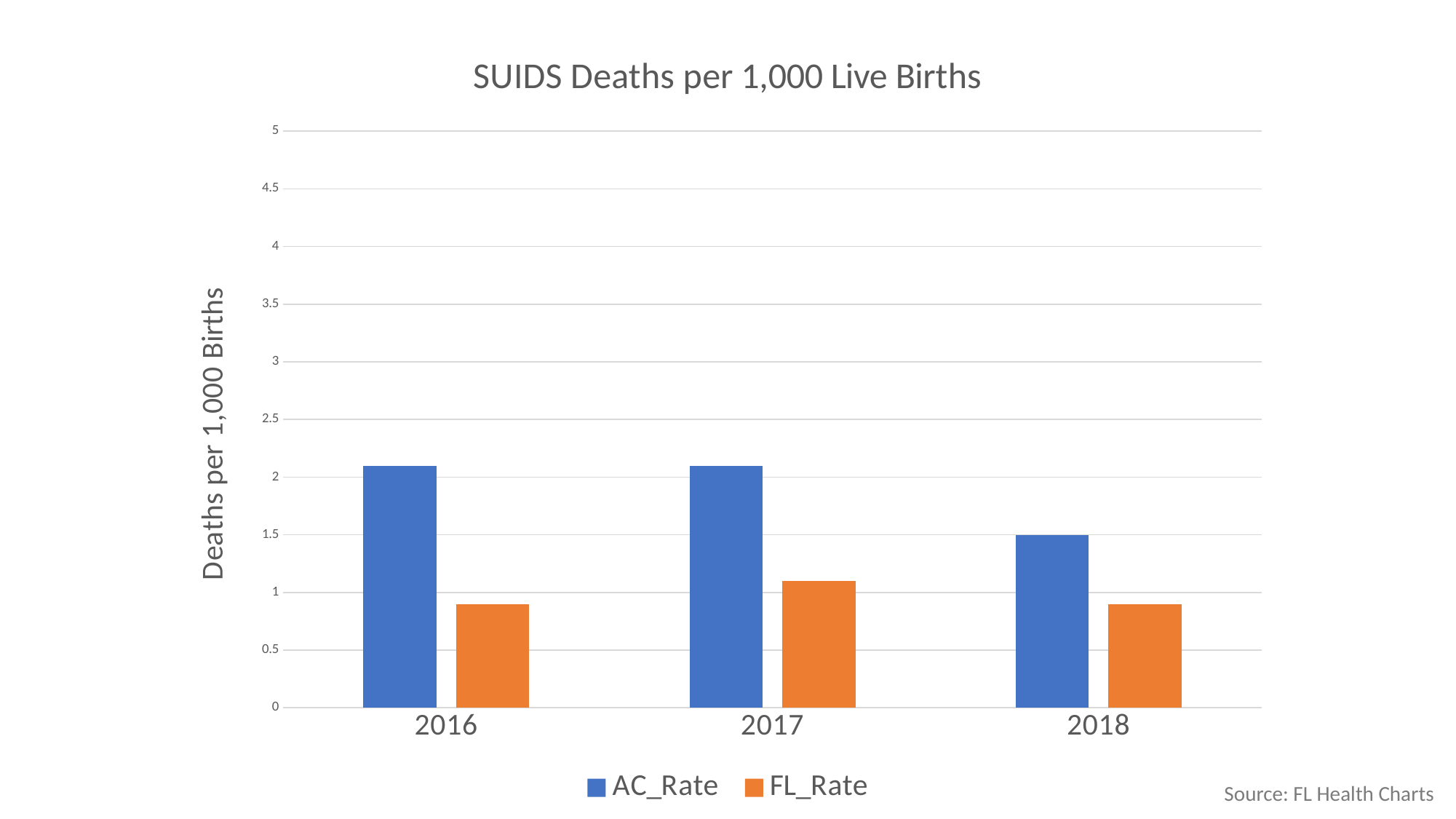
Is the AC_Rate value for 2016 greater or less than 2? greater In which year is the FL_Rate highest? 2017 In 2016, which is larger, AC_Rate or FL_Rate? AC_Rate Is the FL_Rate value for 2018 greater or less than 1? less What is the label on the vertical axis? Deaths per 1,000 Births In which year is the AC_Rate lowest? 2018 Is the FL_Rate value for 2017 greater or less than 1? greater What kind of chart is shown on the slide? bar chart How many years are shown on the x axis? 3 How many series does the legend list? 2 What is the title of the chart? SUIDS Deaths per 1,000 Live Births